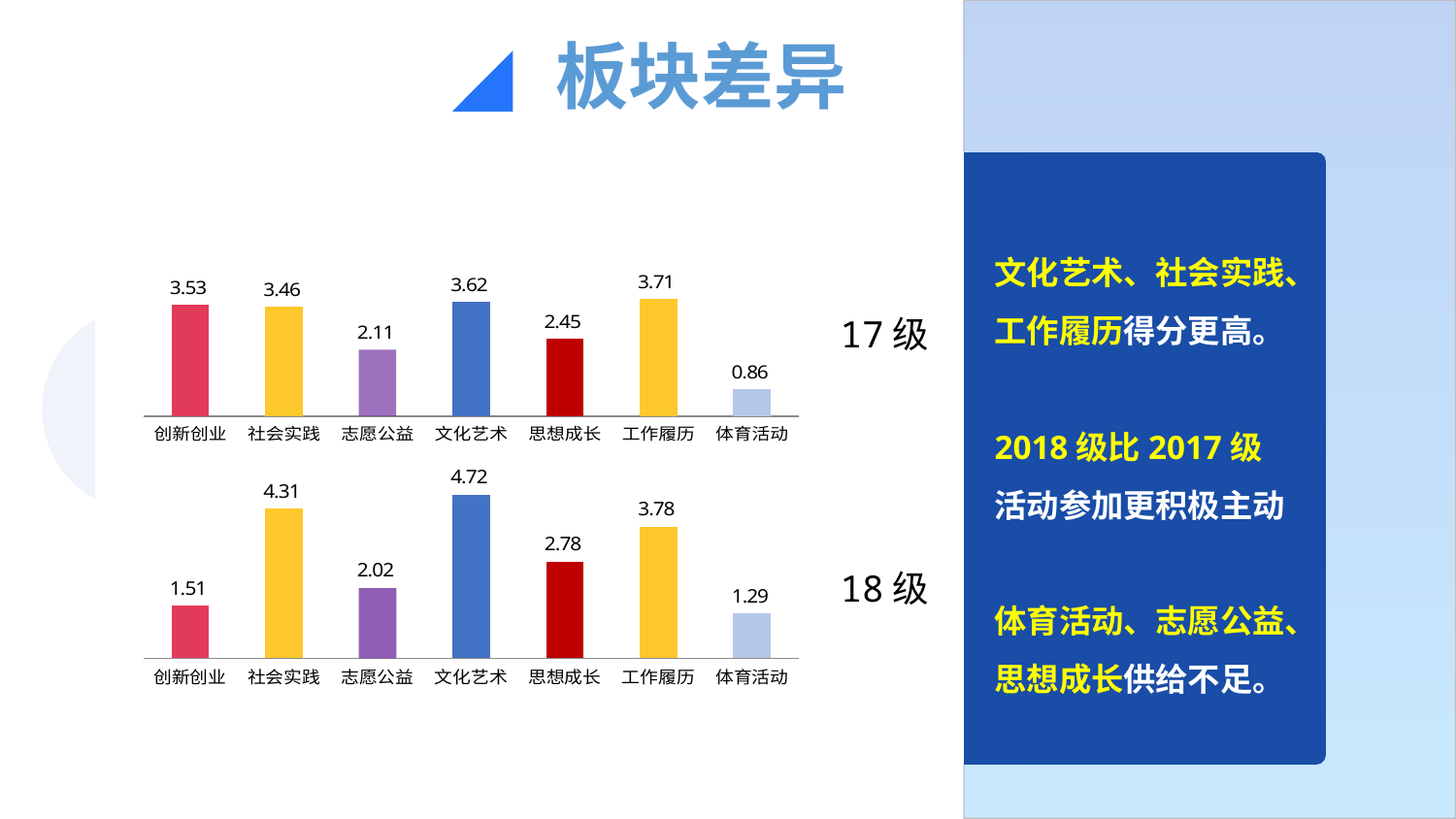
What type of chart is the 17级 chart (top)? bar chart In the 17级 chart (top), what is the difference between 工作履历 and 体育活动? 2.85 In the 17级 chart (top), which category has the lowest value? 体育活动 How many categories are shown in the 18级 chart (bottom)? 7 In the 17级 chart (top), which is larger, 创新创业 or 思想成长? 创新创业 In the 18级 chart (bottom), which category has the highest value? 文化艺术 In the 18级 chart (bottom), which category has the lowest value? 体育活动 In the 18级 chart (bottom), what is the difference between 文化艺术 and 创新创业? 3.21 In the 18级 chart (bottom), what is the value for 社会实践? 4.31 In the 17级 chart (top), which category has the highest value? 工作履历 In the 18级 chart (bottom), what is the value for 思想成长? 2.78 In the 17级 chart (top), what is the value for 文化艺术? 3.62